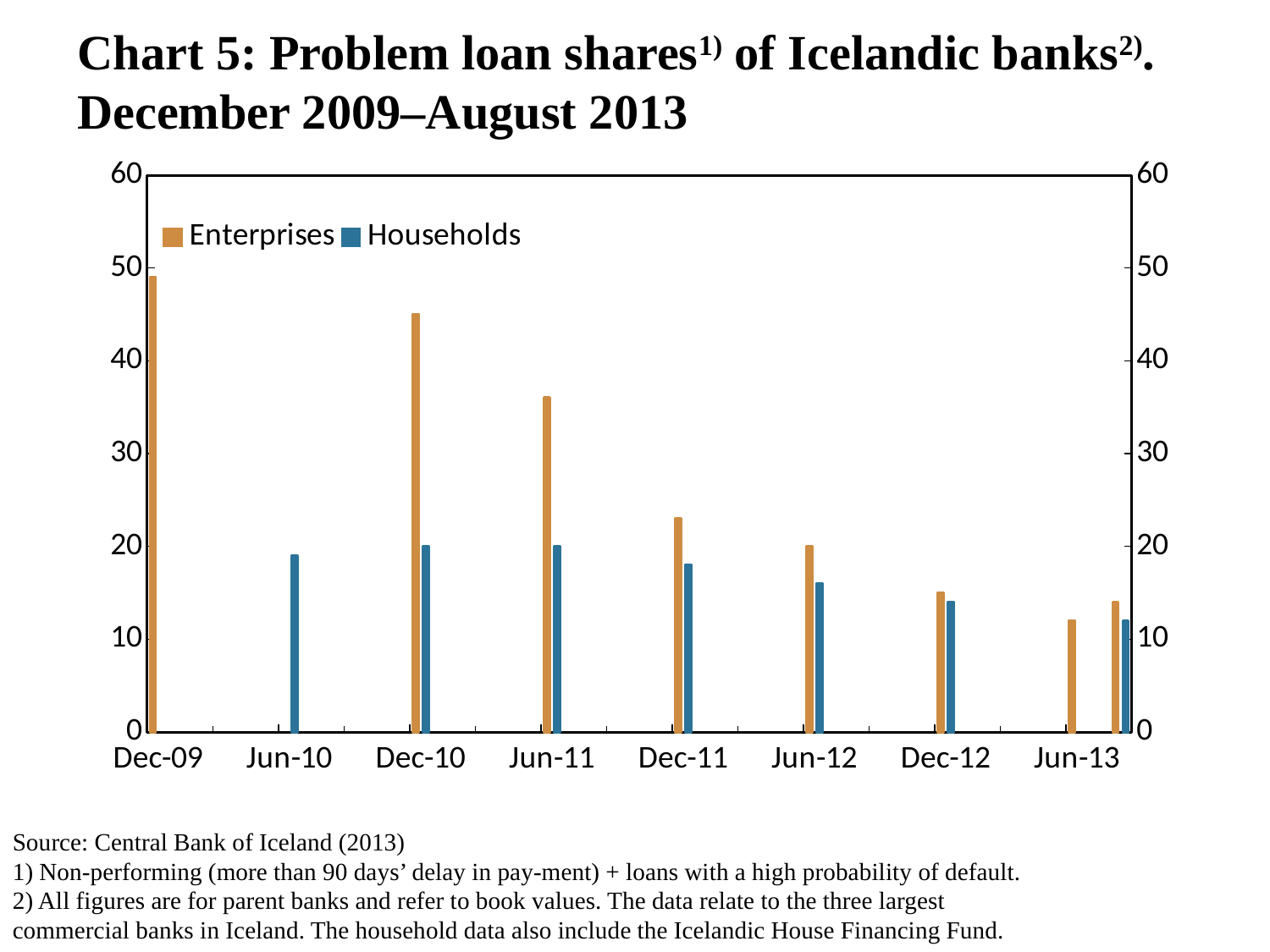
Which two series are shown in the legend? Enterprises and Households Is the Enterprises value for Jun-11 greater or less than 30? greater Is the Enterprises value for Dec-09 greater or less than 40? greater Is the Households value for Dec-12 greater or less than 10? greater Do the Enterprises values generally rise or fall from Dec-09 to Jun-13? fall At Dec-11, which series has the larger value, Enterprises or Households? Enterprises At which date is the Enterprises problem loan share highest? Dec-09 What kind of chart is shown on the slide? Bar chart How many series does the legend list? 2